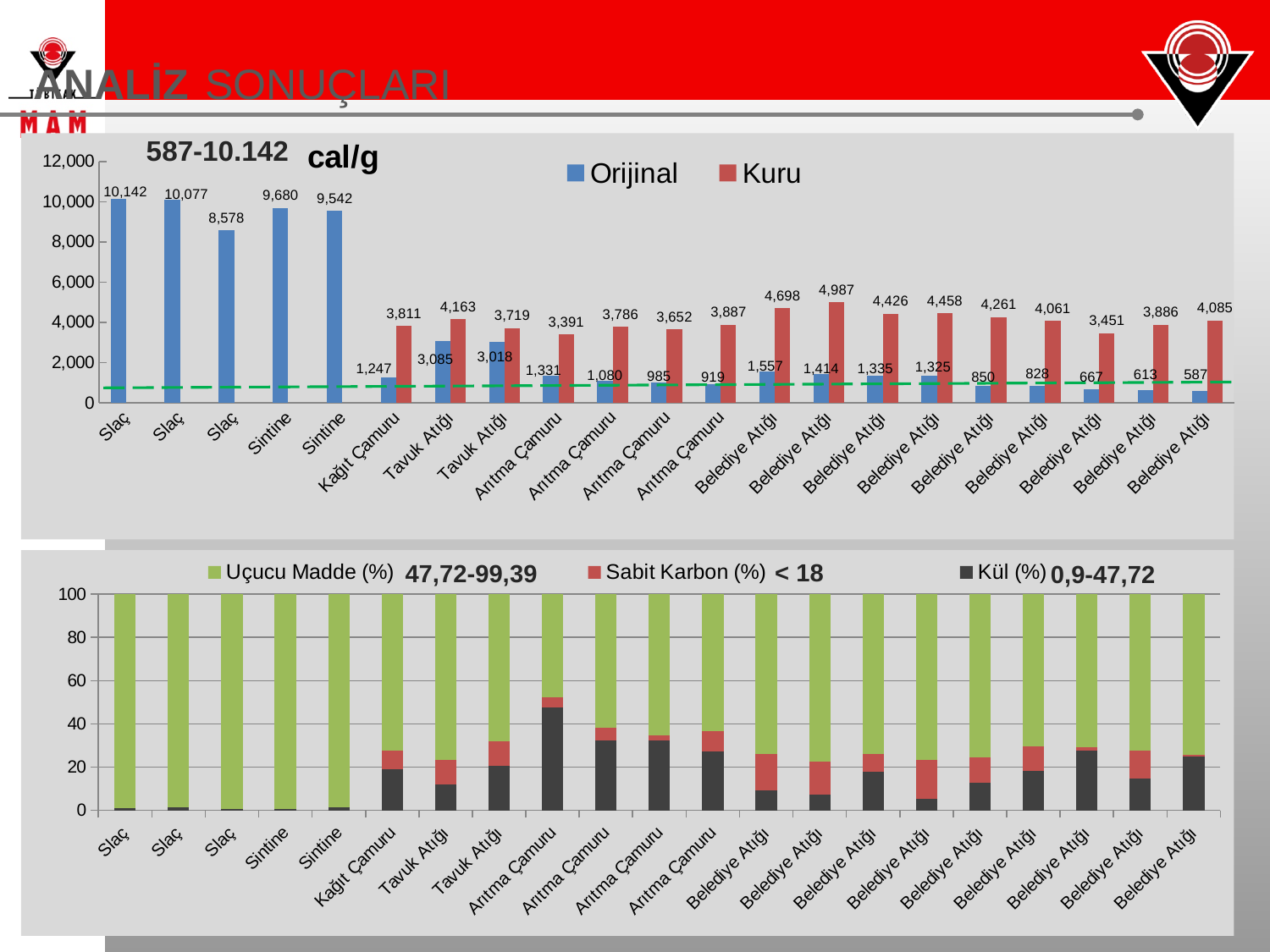
In the bottom chart, how many series does the legend list? 3 In the top chart, what is the highest Kuru value shown? 4,987 In the bottom chart, what are the three legend entries? Uçucu Madde (%), Sabit Karbon (%), Kül (%) In the top chart, what is the Kuru value for Kağıt Çamuru? 3,811 What kind of chart is the top chart on the slide? bar chart In the top chart, what is the difference between the Kuru and Orijinal values for Kağıt Çamuru? 2,564 In the top chart, which is larger for Kağıt Çamuru, the Orijinal value or the Kuru value? Kuru In the top chart, what is the highest Orijinal value shown? 10,142 In the top chart, what is the Orijinal value for Kağıt Çamuru? 1,247 In the bottom chart, how many categories are plotted along the x axis? 21 In the top chart, how many series does the legend list? 2 In the bottom chart, is the Kül (%) value for the first Arıtma Çamuru bar greater or less than 40? greater